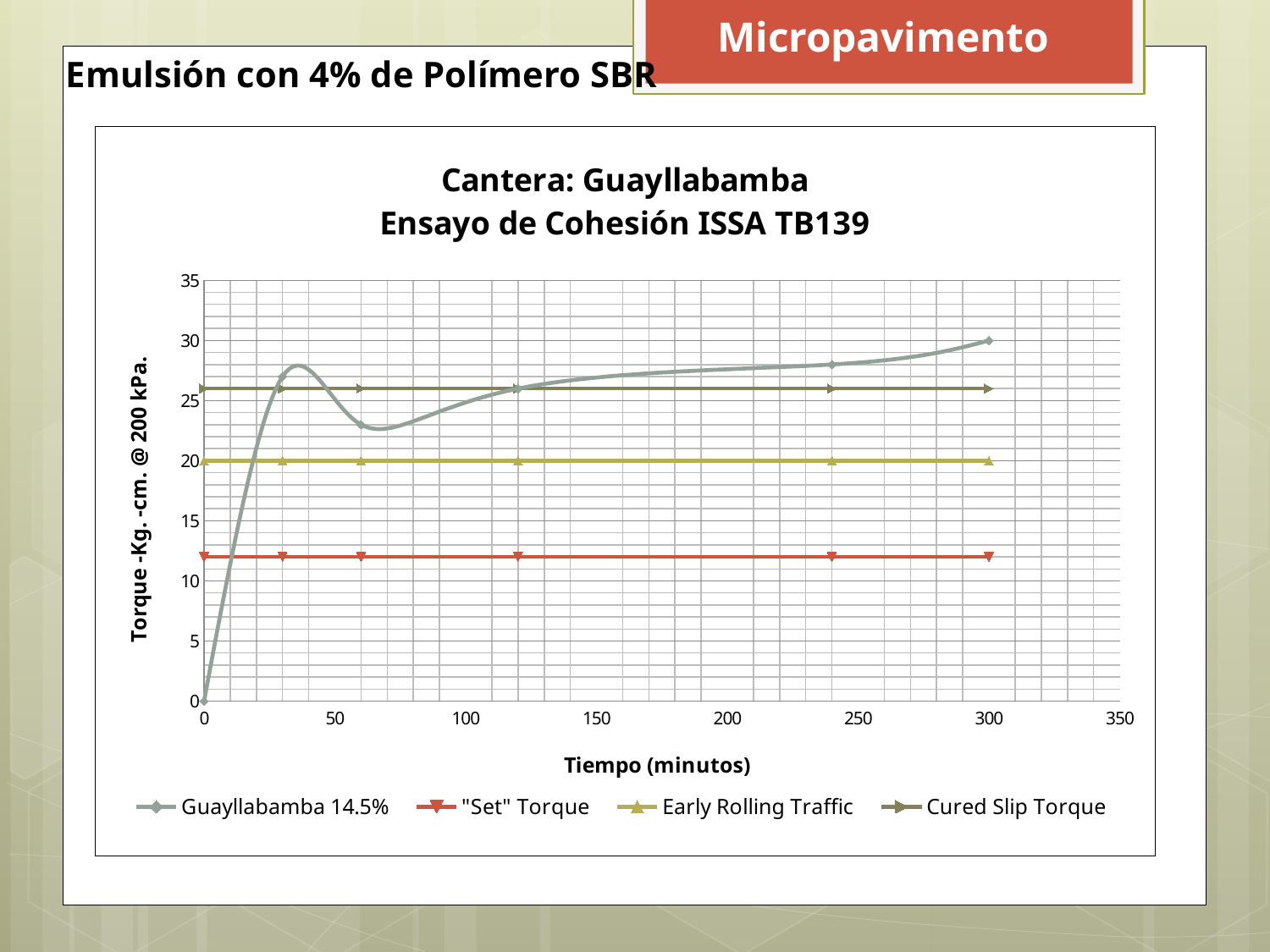
What kind of chart is shown on the slide? Line chart What is the value of the Early Rolling Traffic line? 20 What is the title of the x axis? Tiempo (minutos) How many data points are plotted for the Guayllabamba 14.5% series? 6 Is the value of the Cured Slip Torque line greater or less than 25? greater At 120 minutes, which is larger: the Guayllabamba 14.5% series or the Early Rolling Traffic line? Guayllabamba 14.5% What is the value of the Guayllabamba 14.5% series at 0 minutes? 0 How many series does the legend list? 4 Is the value of the "Set" Torque line greater or less than 15? less Does the Guayllabamba 14.5% series rise or fall between 120 and 300 minutes? rise Is the value of the Guayllabamba 14.5% series at 60 minutes greater or less than 25? less What is the value of the Guayllabamba 14.5% series at 300 minutes? 30